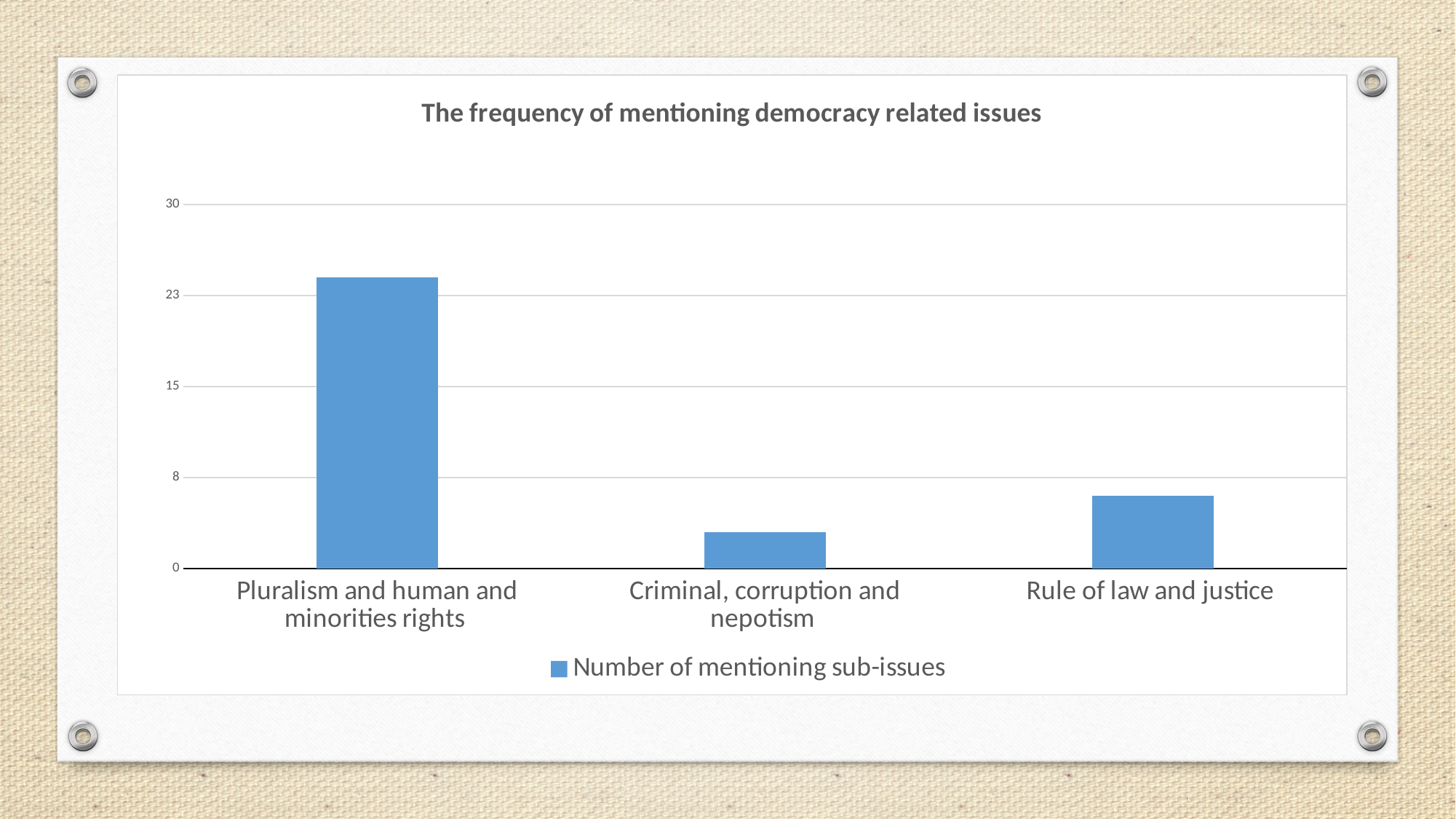
Which category has the highest number of mentioning sub-issues? Pluralism and human and minorities rights How many series does the legend list? 1 Is the value for Pluralism and human and minorities rights greater or less than 30? less What kind of chart is shown on the slide? bar chart Which category has the lowest number of mentioning sub-issues? Criminal, corruption and nepotism Which has a larger value: Rule of law and justice or Criminal, corruption and nepotism? Rule of law and justice Is the value for Rule of law and justice greater or less than 8? less Is the value for Pluralism and human and minorities rights greater or less than 23? greater How many categories are shown on the x axis of the chart? 3 What is the title of the chart? The frequency of mentioning democracy related issues What series name is shown in the legend? Number of mentioning sub-issues